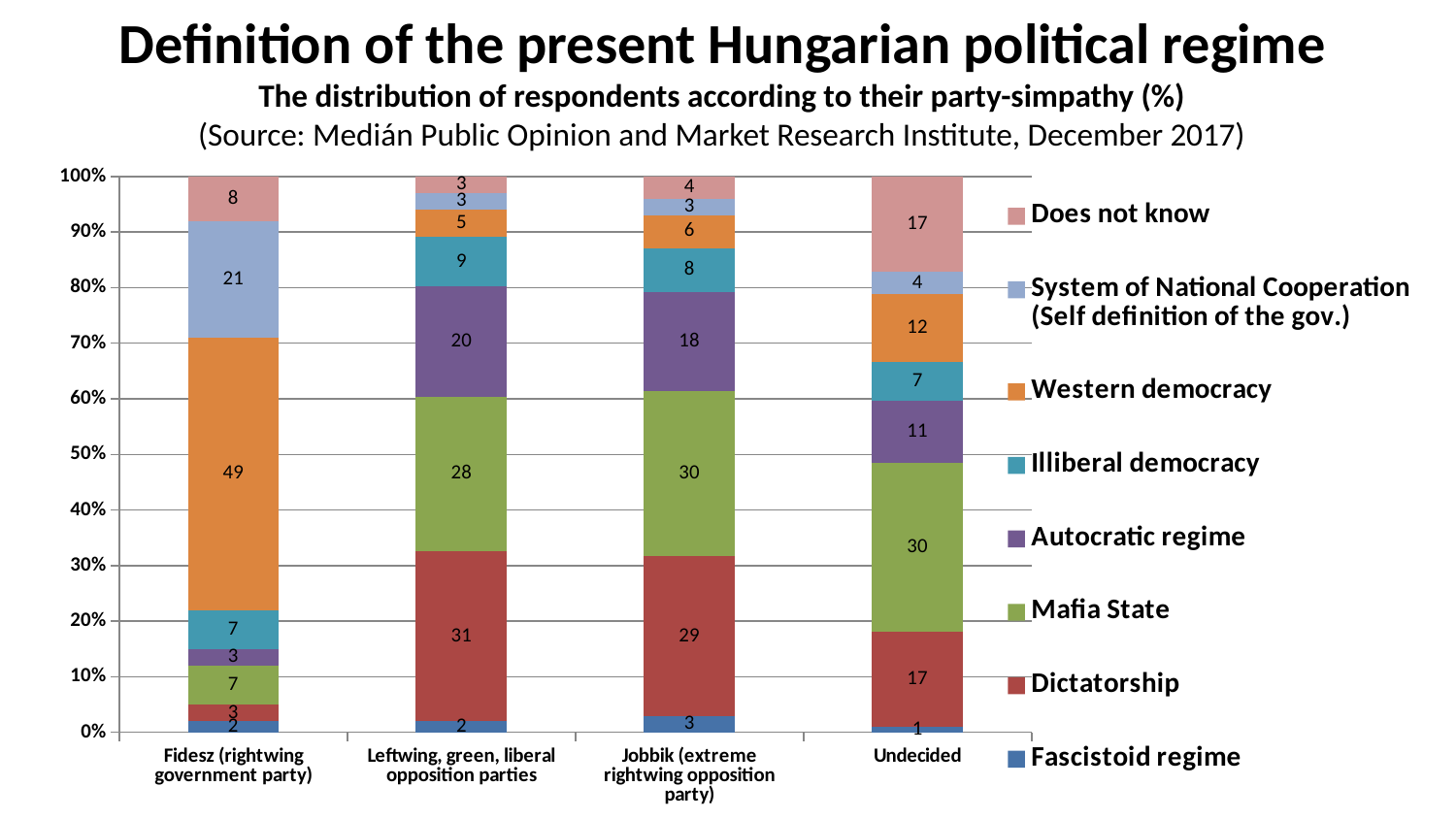
How many series does the legend list? 8 What is the difference between the Western democracy values for Fidesz and Undecided respondents? 37 What is the value for Mafia State among Jobbik (extreme rightwing opposition party) respondents? 30 What percentage of Fidesz sympathisers define the regime as a Western democracy? 49 What is the value for Does not know among Undecided respondents? 17 Which party group has the highest value for System of National Cooperation (Self definition of the gov.)? Fidesz (rightwing government party) Which is larger: the Autocratic regime value for Leftwing, green, liberal opposition parties or for Jobbik? Leftwing, green, liberal opposition parties Which party group has the lowest value for Fascistoid regime? Undecided What is the value for Dictatorship among Leftwing, green, liberal opposition parties respondents? 31 What kind of chart is shown on the slide? Stacked bar chart Which legend entry is shown in green? Mafia State How many party groups are shown on the x axis? 4